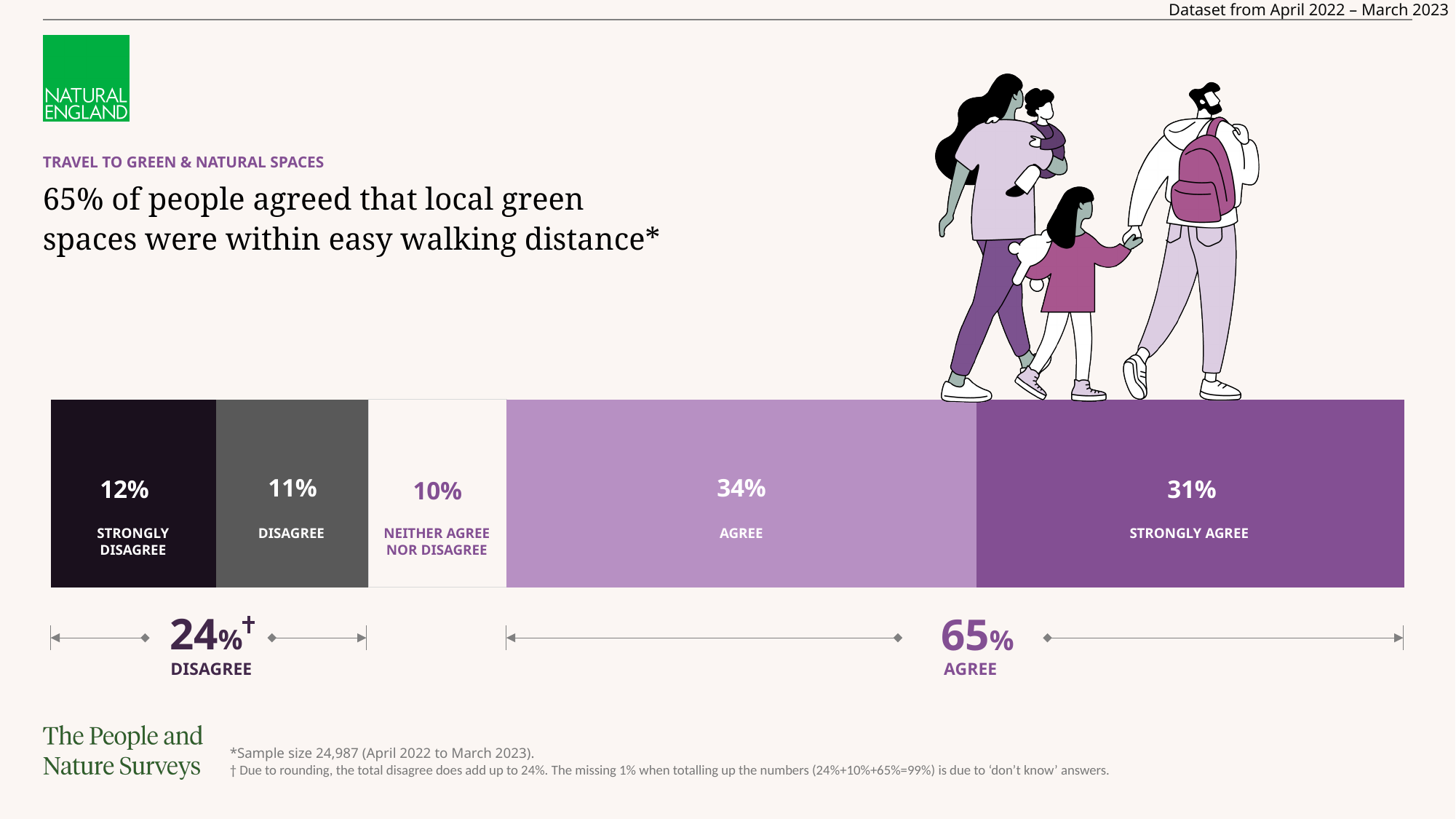
What percentage of people strongly agreed that local green spaces were within easy walking distance? 31% How many response categories are shown in the bar? 5 What kind of chart is shown on the slide? Stacked bar chart What percentage of people answered 'Neither agree nor disagree'? 10% What is the combined percentage of people who disagreed, as shown on the slide? 24% Which response category has the highest percentage? Agree What percentage of people strongly disagreed? 12% What is the difference between the 'Agree' and 'Strongly agree' percentages? 3% Which is larger, the 'Strongly disagree' percentage or the 'Disagree' percentage? Strongly disagree What percentage of people answered 'Agree'? 34% Which response category has the lowest percentage? Neither agree nor disagree What is the combined percentage of people who agreed (Agree plus Strongly agree)? 65%